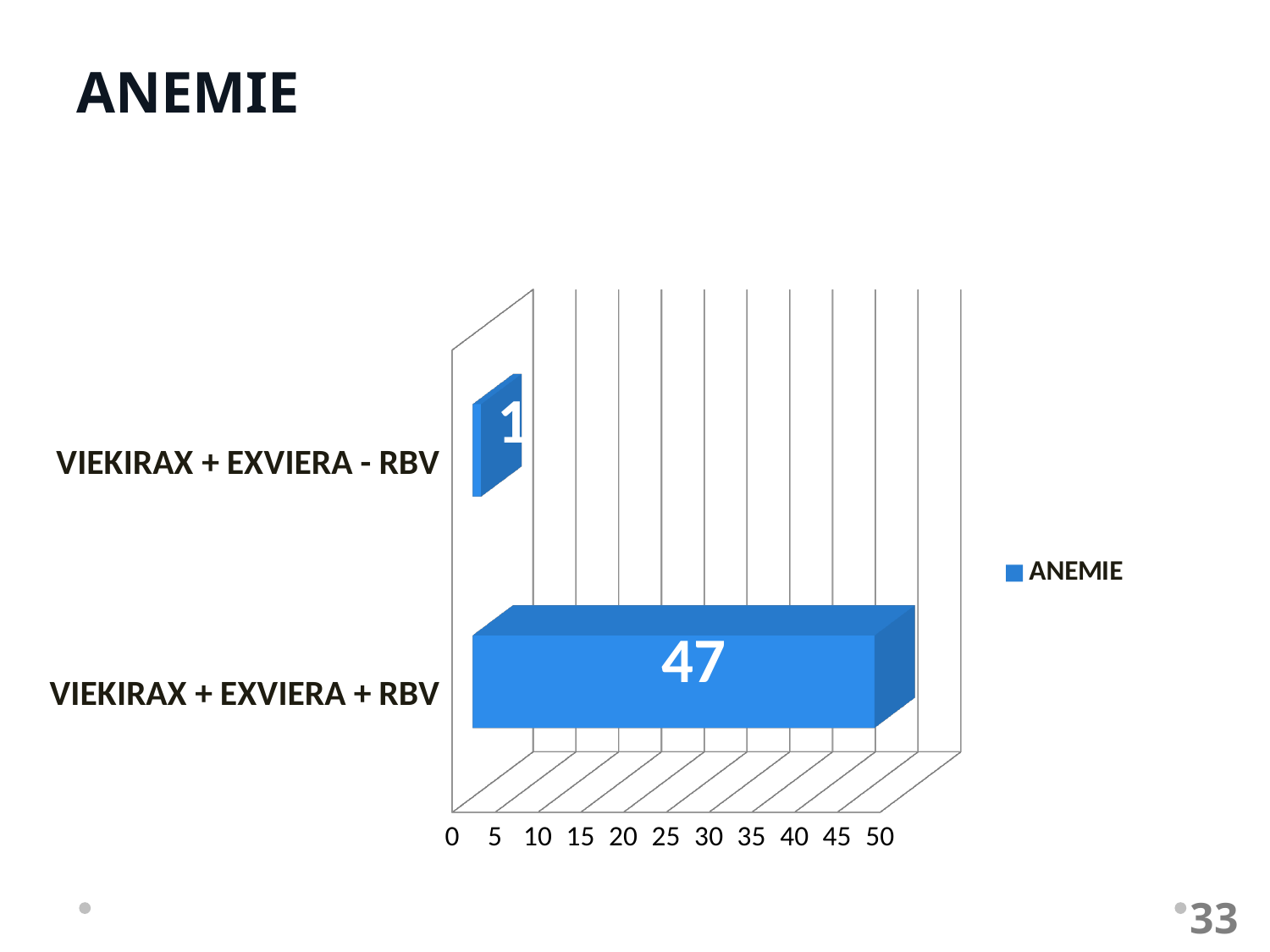
What is the title of the slide? ANEMIE Is the value for VIEKIRAX + EXVIERA - RBV greater or less than 20? less How many series does the legend list? 1 Which is larger, the value for VIEKIRAX + EXVIERA + RBV or the value for VIEKIRAX + EXVIERA - RBV? VIEKIRAX + EXVIERA + RBV What type of chart is shown on the slide? bar chart Which category has the lowest value? VIEKIRAX + EXVIERA - RBV What is the name of the series shown in the legend? ANEMIE How many categories are shown in the chart? 2 Which category has the highest value? VIEKIRAX + EXVIERA + RBV What is the value for VIEKIRAX + EXVIERA + RBV? 47 What is the value for VIEKIRAX + EXVIERA - RBV? 1 Is the value for VIEKIRAX + EXVIERA + RBV greater or less than 40? greater